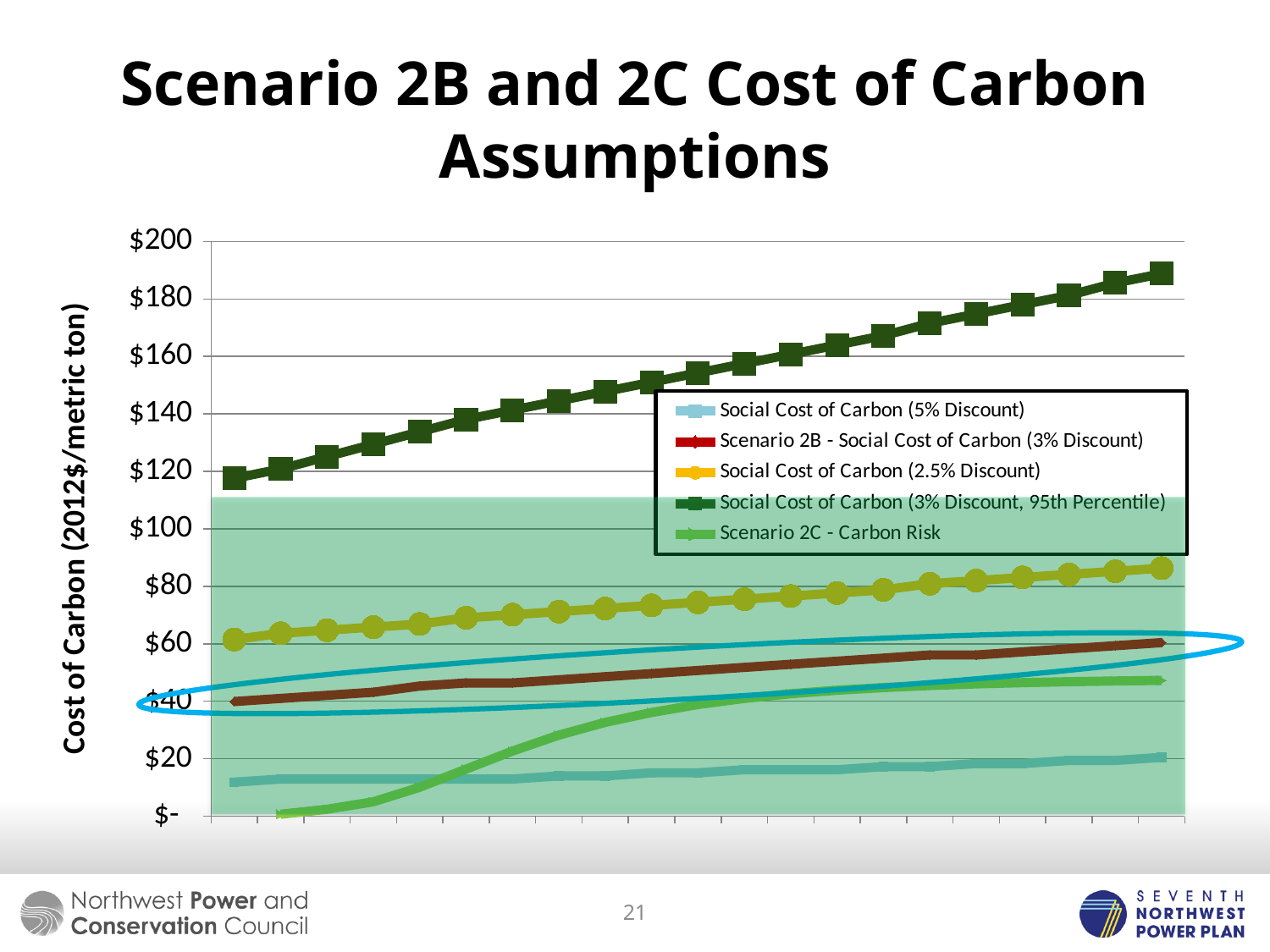
Is the last value of the Social Cost of Carbon (3% Discount, 95th Percentile) series greater or less than $180? greater Is the first value of the Scenario 2C - Carbon Risk series greater or less than $20? less What kind of chart is shown on the slide? line chart Do the values of the Social Cost of Carbon (3% Discount, 95th Percentile) series rise or fall along the x axis? rise Which series has the highest values across the chart? Social Cost of Carbon (3% Discount, 95th Percentile) What is the label on the vertical axis of the chart? Cost of Carbon (2012$/metric ton) Is the first value of the Social Cost of Carbon (3% Discount, 95th Percentile) series greater or less than $100? greater At the right end of the chart, which is larger: Scenario 2B - Social Cost of Carbon (3% Discount) or Social Cost of Carbon (2.5% Discount)? Social Cost of Carbon (2.5% Discount) How many series does the legend list? 5 Do the values of the Scenario 2C - Carbon Risk series rise or fall along the x axis? rise